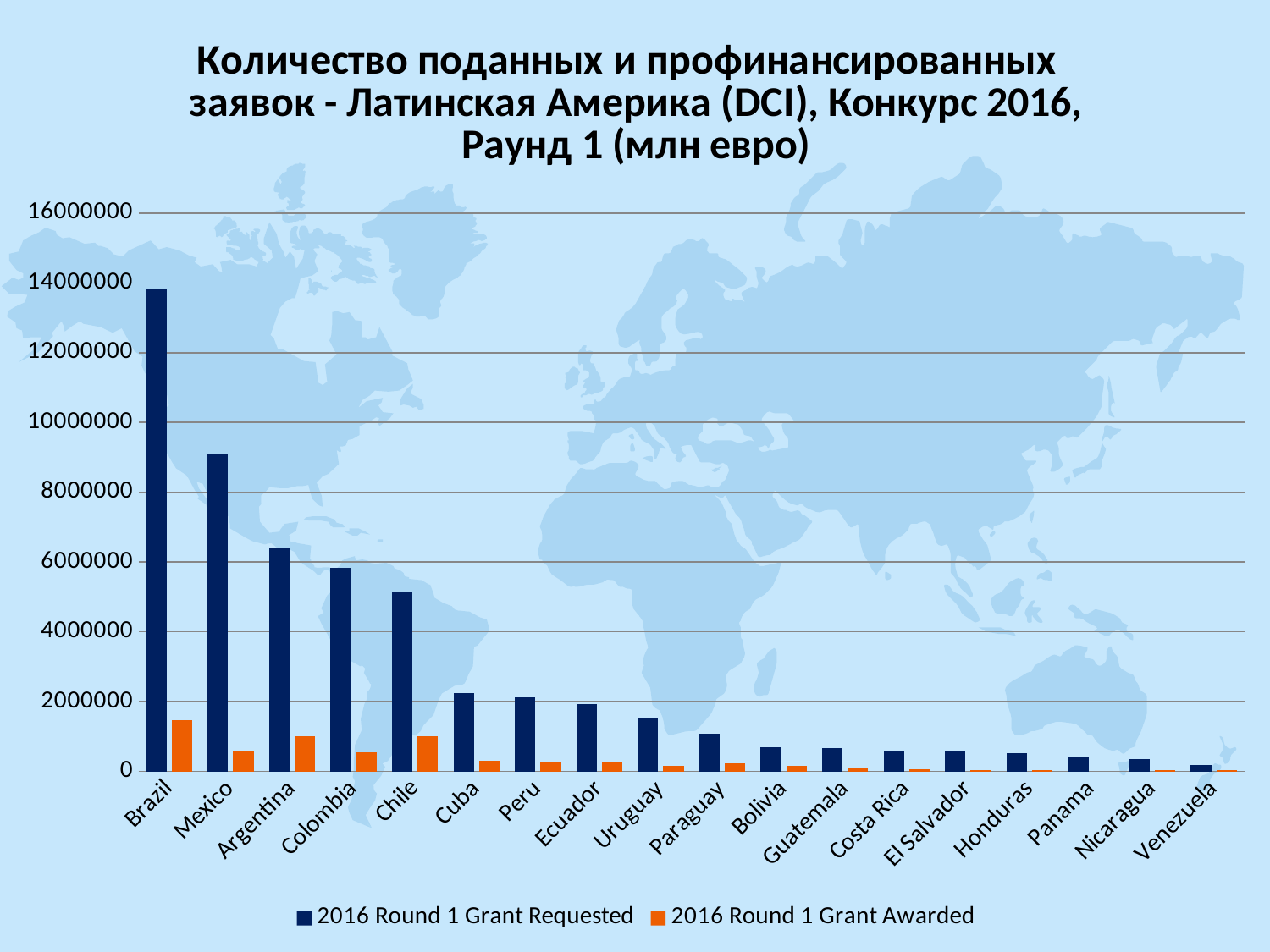
Is the 2016 Round 1 Grant Requested value for Brazil greater or less than 12000000? greater Do the 2016 Round 1 Grant Requested values rise or fall from Brazil to Venezuela along the x axis? fall Which country has the highest 2016 Round 1 Grant Awarded value? Brazil Is the 2016 Round 1 Grant Awarded value for Brazil greater or less than 2000000? less Which country has the highest 2016 Round 1 Grant Requested value? Brazil What kind of chart is shown on the slide? bar chart How many series does the legend list? 2 Is the 2016 Round 1 Grant Requested value for Mexico greater or less than 10000000? less Which has the larger 2016 Round 1 Grant Requested value, Mexico or Argentina? Mexico How many countries are shown on the x axis? 18 Which country has the lowest 2016 Round 1 Grant Requested value? Venezuela